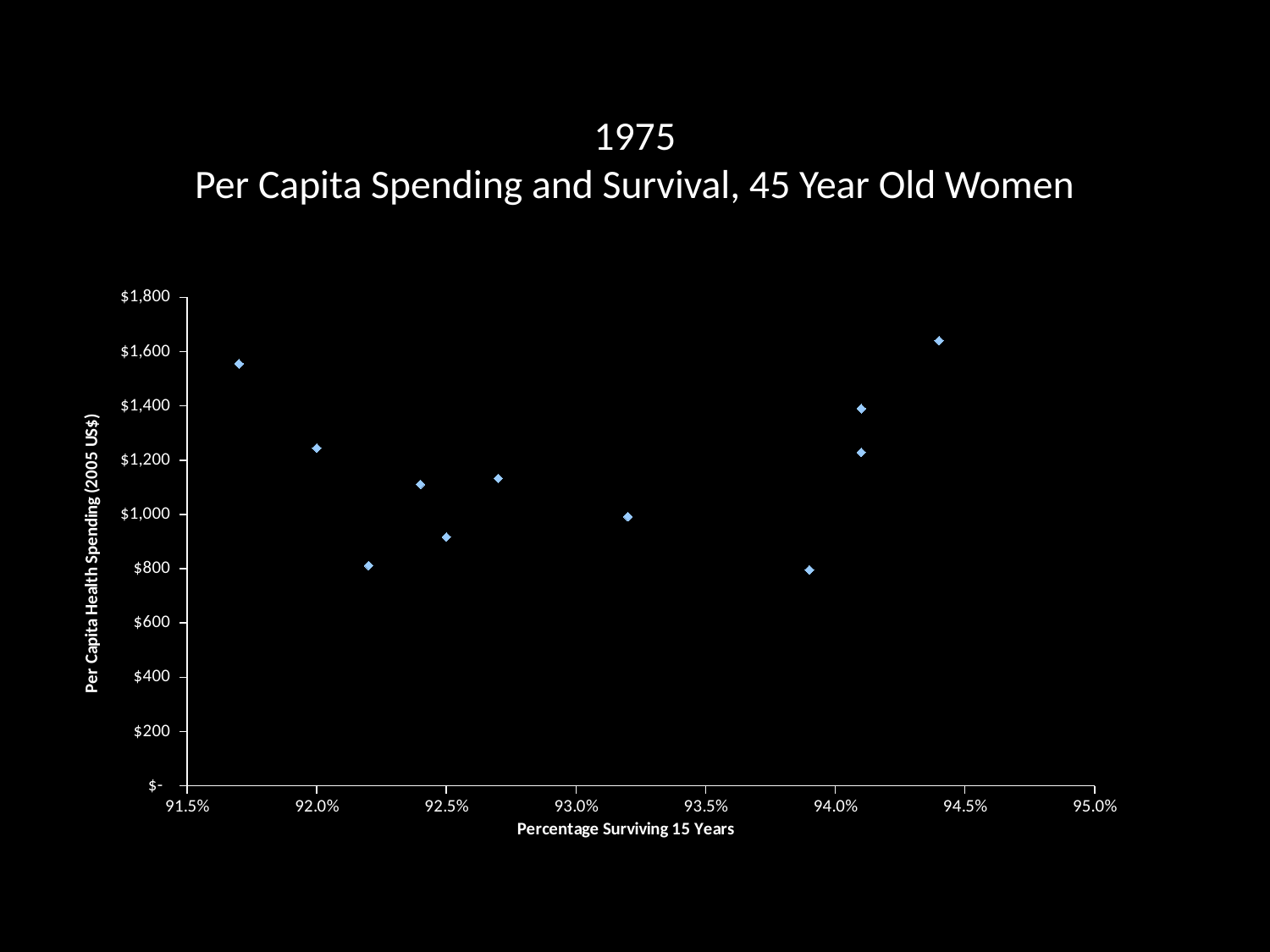
Is the spending value for the point at about 93.2% survival greater or less than $1,200? less How many points have spending above $1,500? 2 Which has higher spending: the point at about 92.0% survival or the point at about 92.2% survival? The point at about 92.0% survival What kind of chart is shown on the slide? Scatter plot Is the spending value for the point at about 93.9% survival greater or less than $1,000? less Is the spending value for the point at about 94.4% survival greater or less than $1,400? greater How many data points are plotted on the chart? 11 Is the survival percentage of the point with the highest spending greater or less than 94.0%? greater What is the label of the vertical axis? Per Capita Health Spending (2005 US$) What is the title of the chart? 1975 Per Capita Spending and Survival, 45 Year Old Women